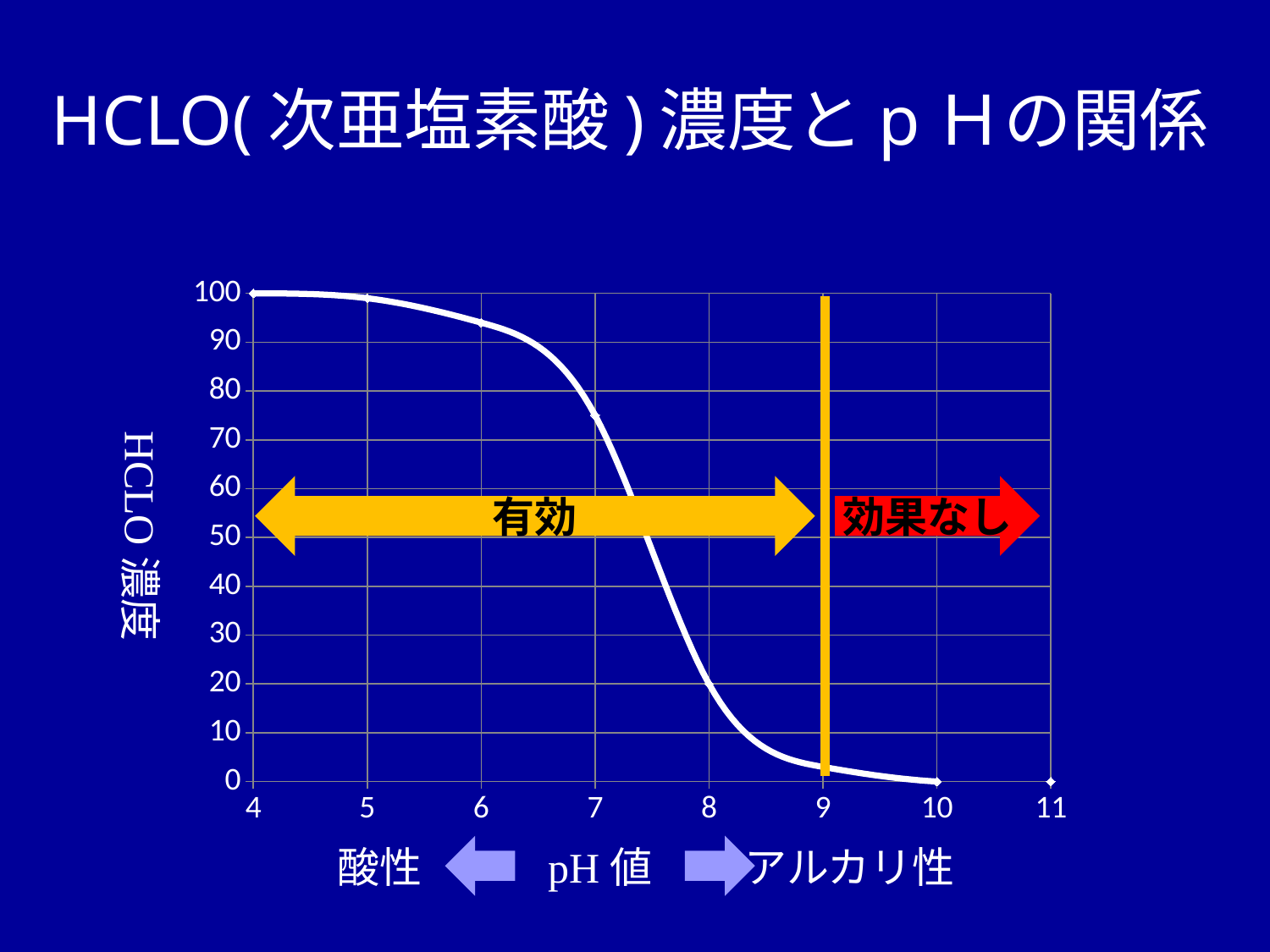
Is the HCLO concentration at pH 8 greater or less than 50? less What is the HCLO concentration at pH 4? 100 Is the HCLO concentration at pH 5 greater or less than 90? greater How many pH values are labelled on the x axis? 8 At which pH value is the vertical orange line separating 有効 from 効果なし drawn? 9 What kind of chart is shown on the slide? line chart Which has the higher HCLO concentration, pH 6 or pH 8? pH 6 Is the HCLO concentration at pH 6 greater or less than 80? greater What is the label on the vertical axis of the chart? HCLO 濃度 As pH increases along the x axis, does the HCLO concentration rise or fall? fall